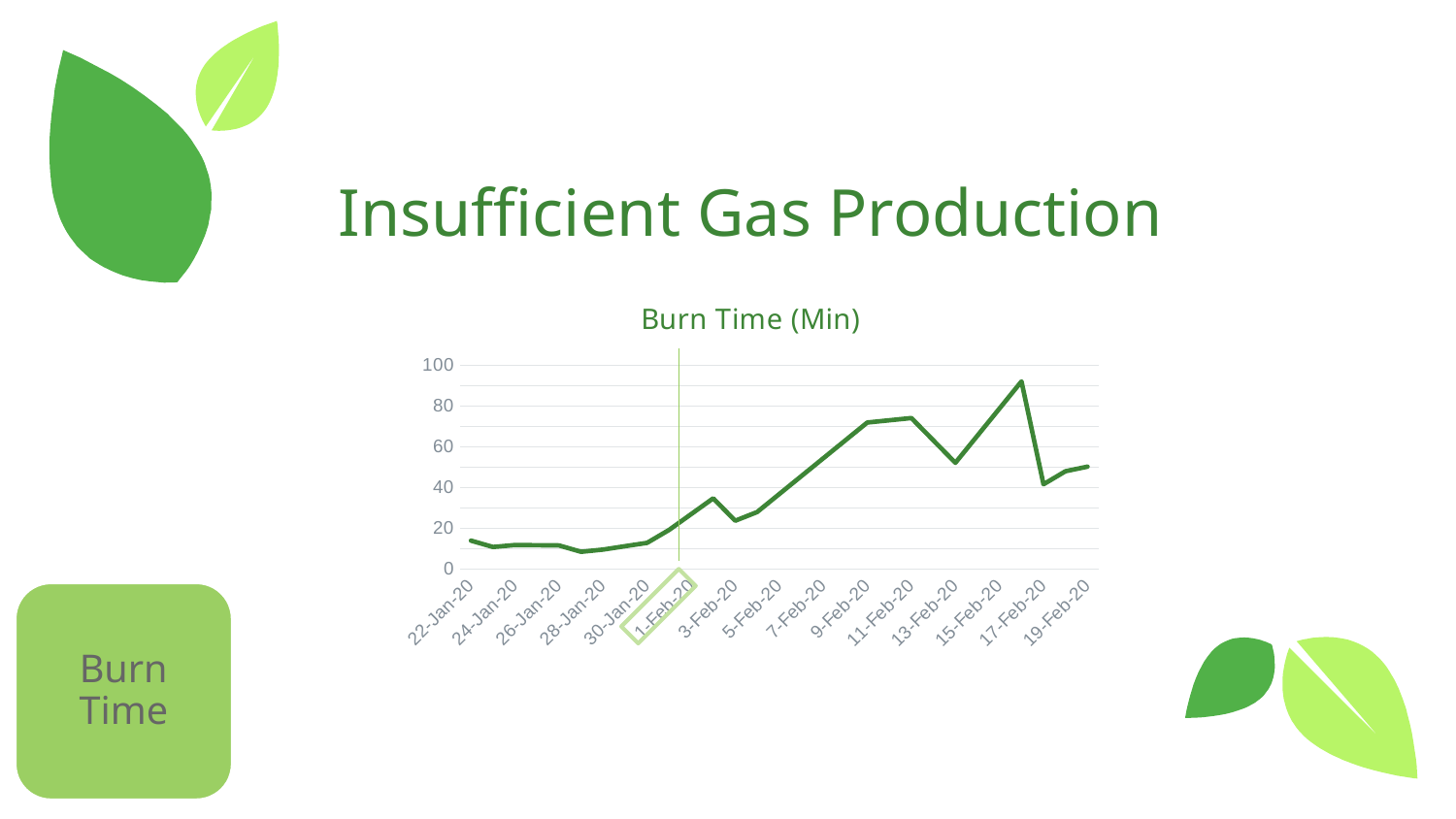
How many date labels are shown on the x axis? 15 Is the value for 13-Feb-20 greater or less than 60? less Which date label on the x axis is highlighted with a box? 1-Feb-20 Is the highest value on the line greater or less than 80? greater What is the title of the chart? Burn Time (Min) Is the value for 9-Feb-20 greater or less than 60? greater Which has the larger value, 22-Jan-20 or 11-Feb-20? 11-Feb-20 What kind of chart is shown on the slide? line chart Does the burn time rise or fall between 30-Jan-20 and 9-Feb-20? rise